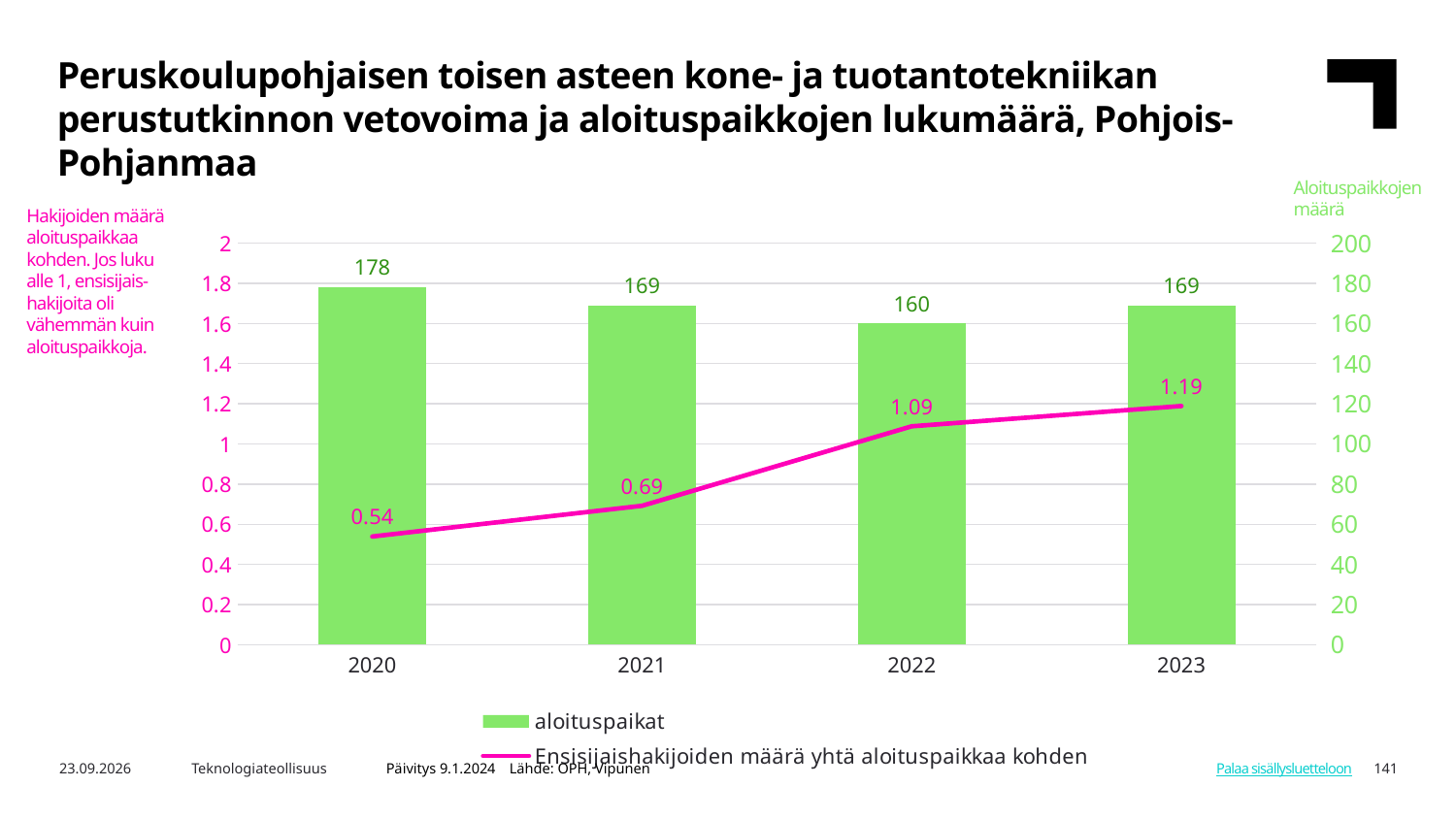
What is the value of Ensisijaishakijoiden määrä yhtä aloituspaikkaa kohden for 2023? 1.19 Which is larger, the Ensisijaishakijoiden määrä yhtä aloituspaikkaa kohden value for 2021 or for 2022? 2022 What is the value of aloituspaikat for 2022? 160 What colour are the aloituspaikat bars? Green Which year has the highest value of aloituspaikat? 2020 Which year has the lowest value of Ensisijaishakijoiden määrä yhtä aloituspaikkaa kohden? 2020 What is the difference in aloituspaikat between 2020 and 2022? 18 How many years are shown on the x axis? 4 What is the value of aloituspaikat for 2020? 178 Does the Ensisijaishakijoiden määrä yhtä aloituspaikkaa kohden line rise or fall from 2020 to 2023? Rise What kind of chart is this? Combined bar and line chart How many series does the legend list? 2